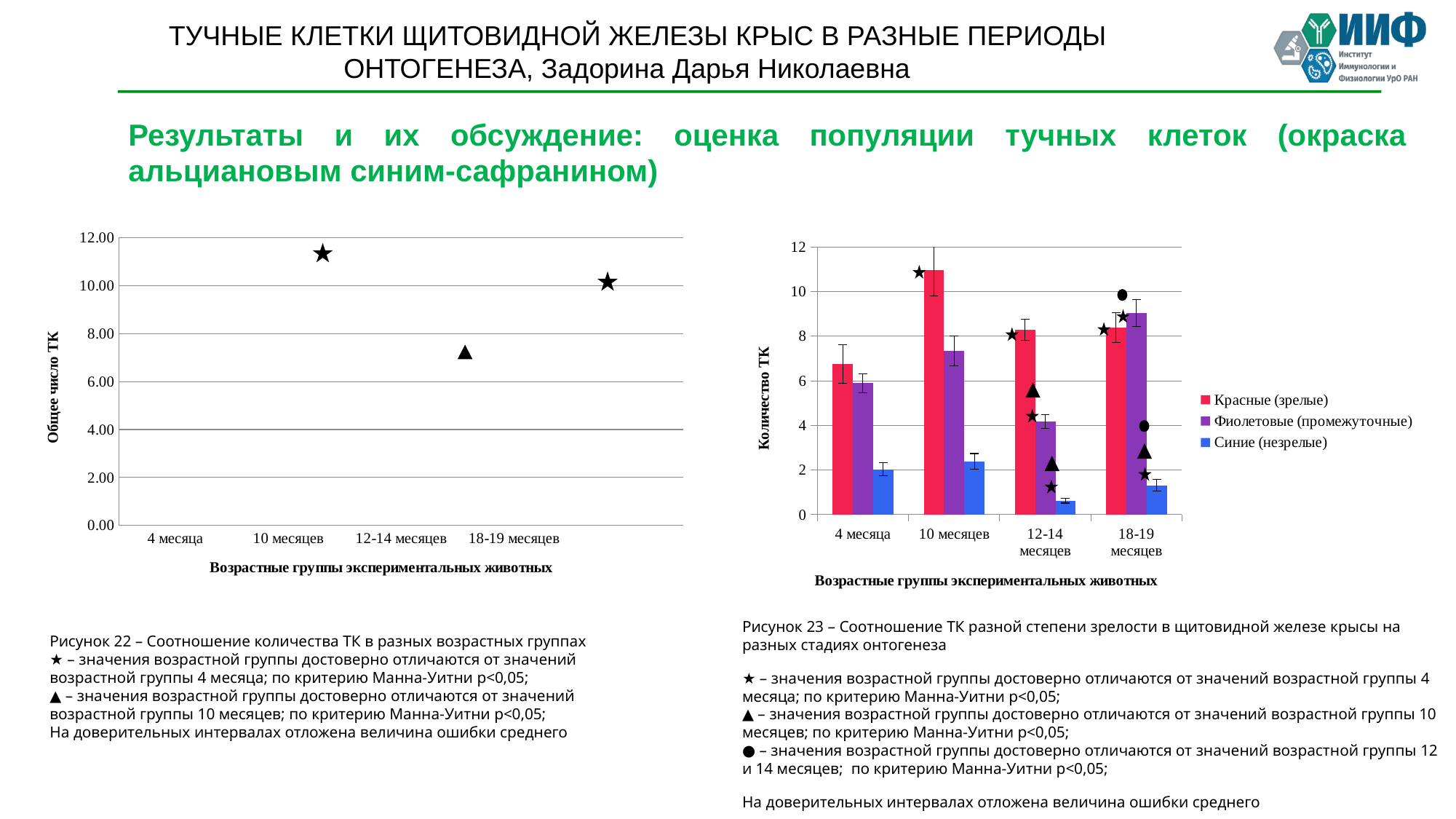
In the right-hand chart, is the Фиолетовые (промежуточные) value for 18-19 месяцев greater or less than 8? greater In the right-hand chart, which is larger for 4 месяца: the Красные (зрелые) bar or the Синие (незрелые) bar? Красные (зрелые) What kind of chart is the right-hand chart (Рисунок 23)? bar chart In the right-hand chart, is the Фиолетовые (промежуточные) bar larger for 10 месяцев or for 12-14 месяцев? 10 месяцев In the right-hand chart, for which age group is the Красные (зрелые) bar the highest? 10 месяцев In the right-hand chart, for which age group is the Синие (незрелые) bar the lowest? 12-14 месяцев How many age-group categories are shown on the x axis of the left-hand chart (Рисунок 22)? 4 What is the y-axis title of the right-hand chart? Количество ТК How many age-group categories are shown on the x axis of the right-hand chart? 4 In the right-hand chart, is the Красные (зрелые) value for 10 месяцев greater or less than 10? greater How many series does the legend of the right-hand chart list? 3 In the right-hand chart, is the Синие (незрелые) value for 12-14 месяцев greater or less than 2? less